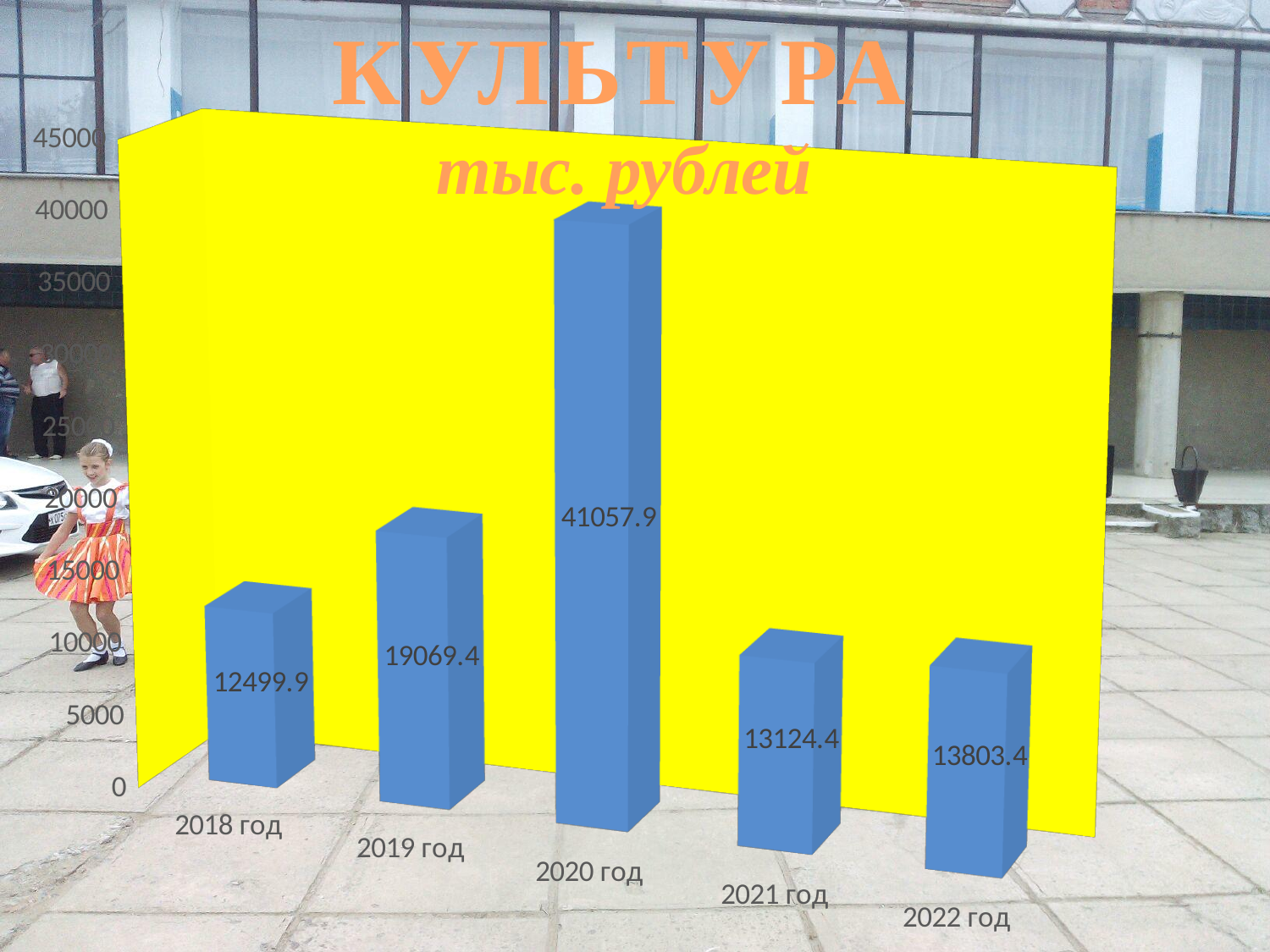
What is the value for 2018 год? 12499.9 What kind of chart is shown on the slide? bar chart Which is larger, the value for 2021 год or 2022 год? 2022 год Is the value for 2020 год greater or less than 40000? greater What unit is given in the chart's subtitle? тыс. рублей What is the difference between the values for 2020 год and 2019 год? 21988.5 What is the value for 2022 год? 13803.4 How many years are shown on the chart? 5 Which year has the lowest value? 2018 год Which year has the highest value? 2020 год What is the value for 2020 год? 41057.9 What is the difference between the values for 2022 год and 2021 год? 679.0